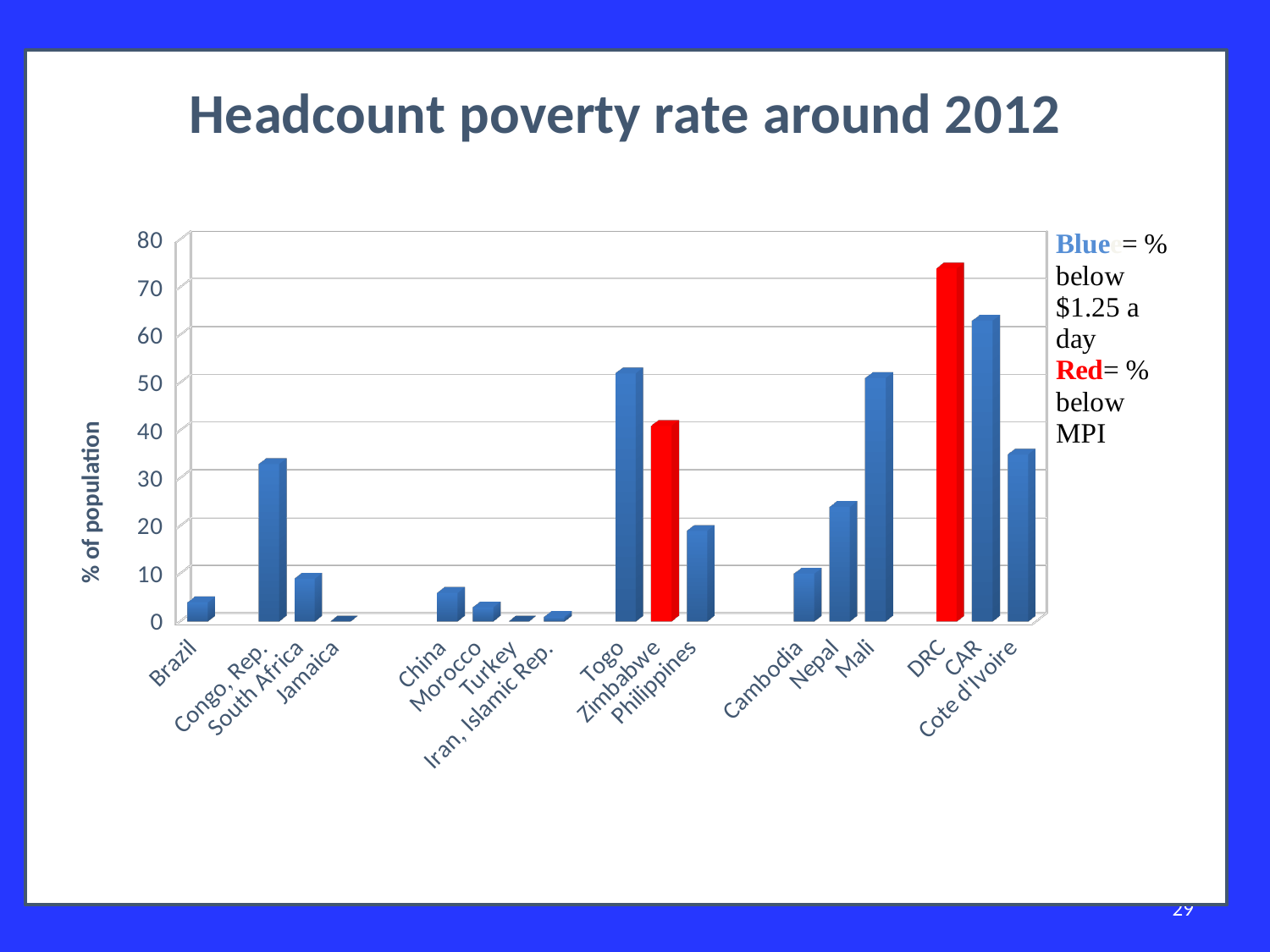
Which has a higher value, Nepal or Philippines? Nepal Is the value for Cambodia greater or less than 20? less How many countries are shown on the x axis of the chart? 17 Is the value for Nepal greater or less than 20? greater Is the value for DRC greater or less than 70? greater According to the slide, what do the red bars represent? % below MPI Which has a higher value, CAR or Togo? CAR What kind of chart is shown on the slide? bar chart Which country has the highest headcount poverty rate in the chart? DRC